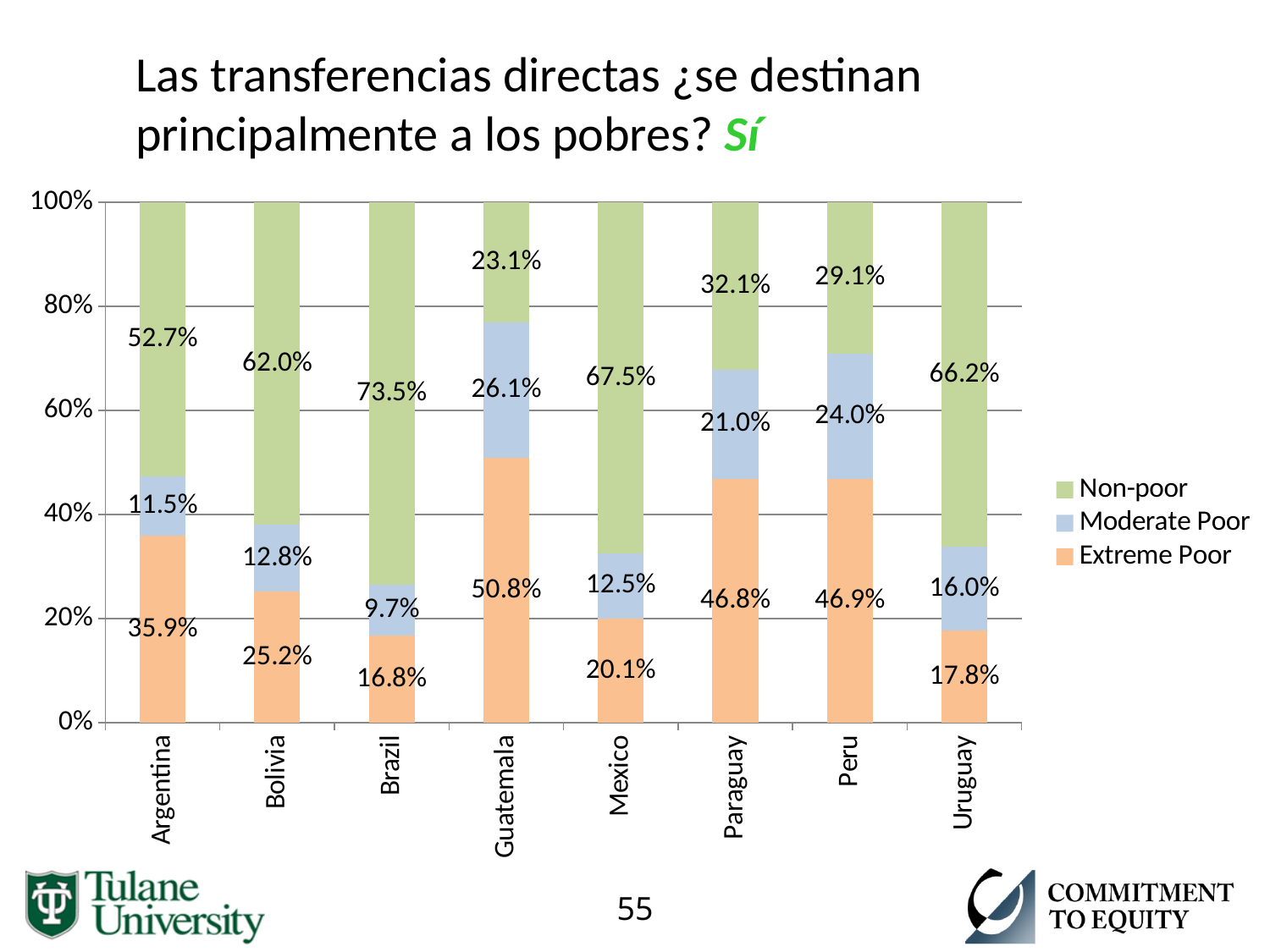
Which has a larger Extreme Poor share, Argentina or Bolivia? Argentina What is the Extreme Poor share for Guatemala? 50.8% How many series does the legend list? 3 How many countries are shown on the x axis? 8 Which country has the lowest Non-poor share? Guatemala What is the Extreme Poor share for Uruguay? 17.8% What is the Moderate Poor share for Peru? 24.0% What kind of chart is shown on the slide? Stacked bar chart What is the difference between the Extreme Poor shares of Guatemala and Brazil? 34.0 percentage points Which country has the highest Extreme Poor share? Guatemala Which country has the lowest Moderate Poor share? Brazil What is the Non-poor share for Brazil? 73.5%